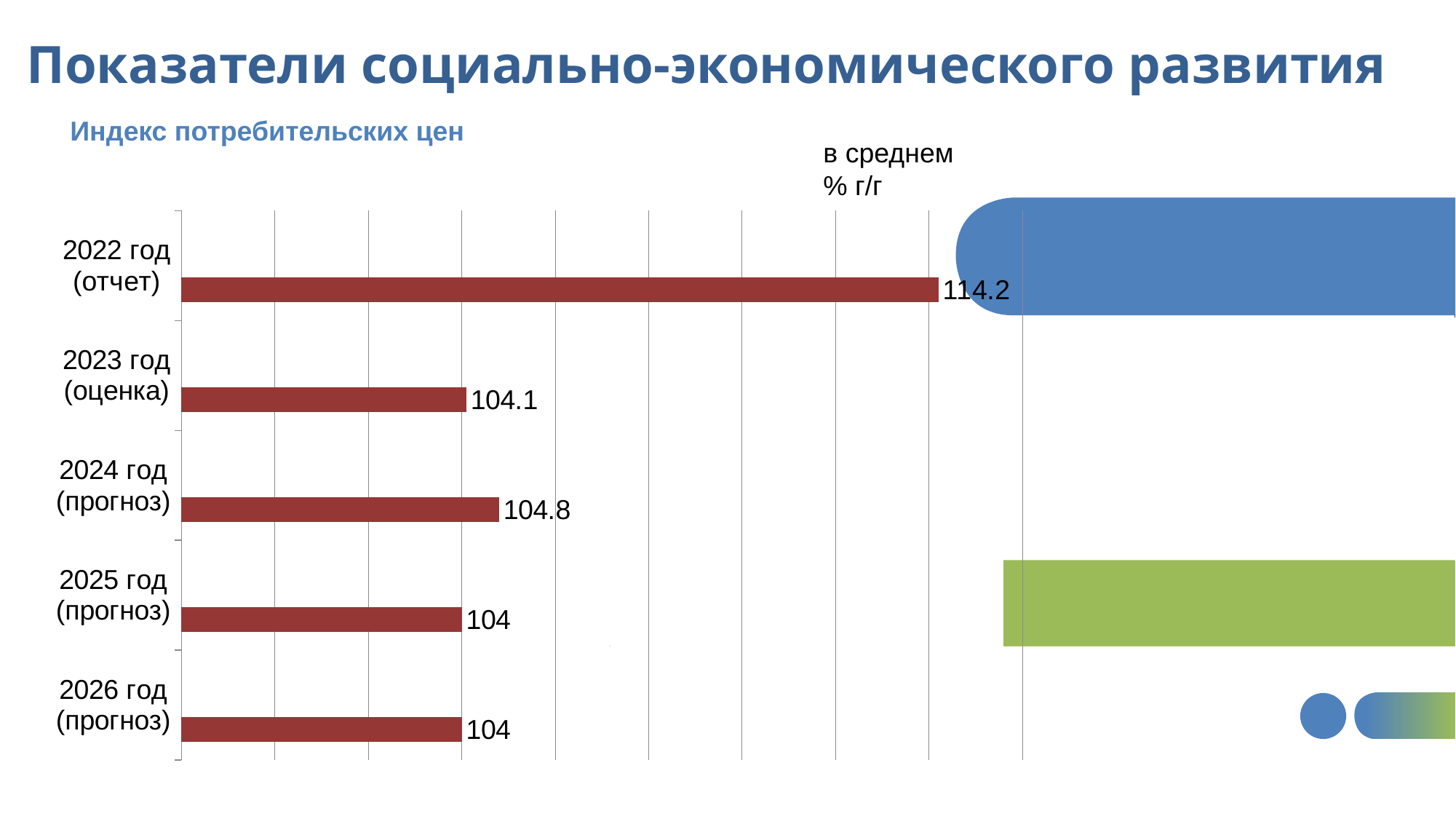
Which is larger, the value for 2023 год (оценка) or for 2024 год (прогноз)? 2024 год (прогноз) What is the title of the chart? Индекс потребительских цен Does the value rise or fall from 2022 год (отчет) to 2023 год (оценка)? Fall Which year has the highest consumer price index value? 2022 год (отчет) What is the difference between the values for 2024 год (прогноз) and 2025 год (прогноз)? 0.8 What is the value shown for 2024 год (прогноз)? 104.8 What kind of chart is used to show the consumer price index? Bar chart What is the difference between the values for 2022 год (отчет) and 2023 год (оценка)? 10.1 What is the value shown for 2023 год (оценка)? 104.1 What is the consumer price index value for 2022 год (отчет)? 114.2 What is the value shown for 2026 год (прогноз)? 104 How many years (categories) are shown in the chart? 5